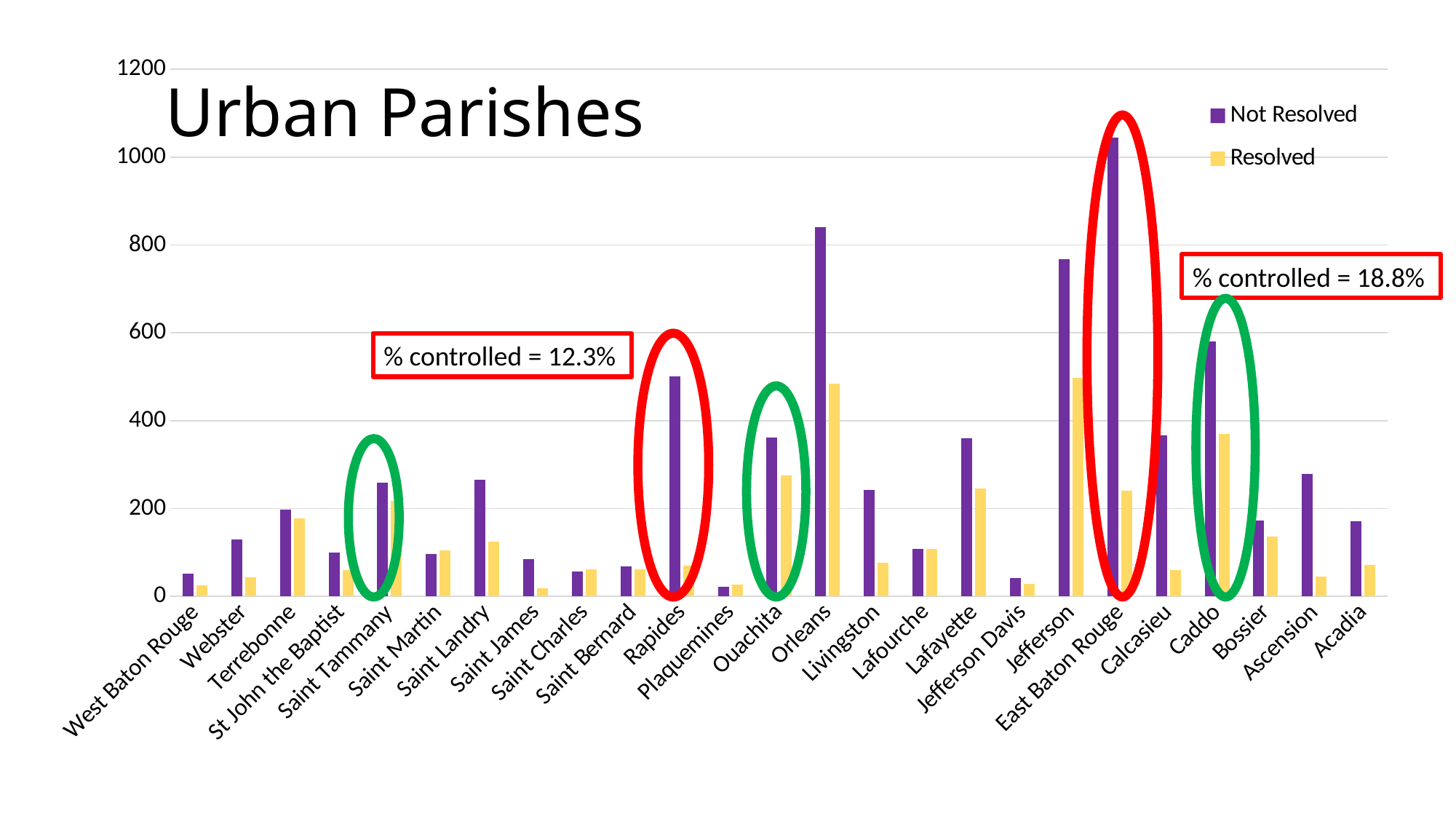
Is the Not Resolved value for East Baton Rouge greater or less than 1000? greater Which parish has the lowest Not Resolved value? Plaquemines Which parish has the highest Not Resolved value? East Baton Rouge Which is larger, the Not Resolved value for Caddo or the Not Resolved value for Calcasieu? Caddo What kind of chart is shown on the slide? Bar chart What are the two series named in the legend? Not Resolved and Resolved What is the title of the chart? Urban Parishes How many parishes are shown on the x axis? 25 Which is larger, the Not Resolved value for Orleans or the Not Resolved value for Jefferson? Orleans How many series does the legend list? 2 Is the Not Resolved value for Saint Tammany greater or less than 200? greater Is the Not Resolved value for Orleans greater or less than 800? greater